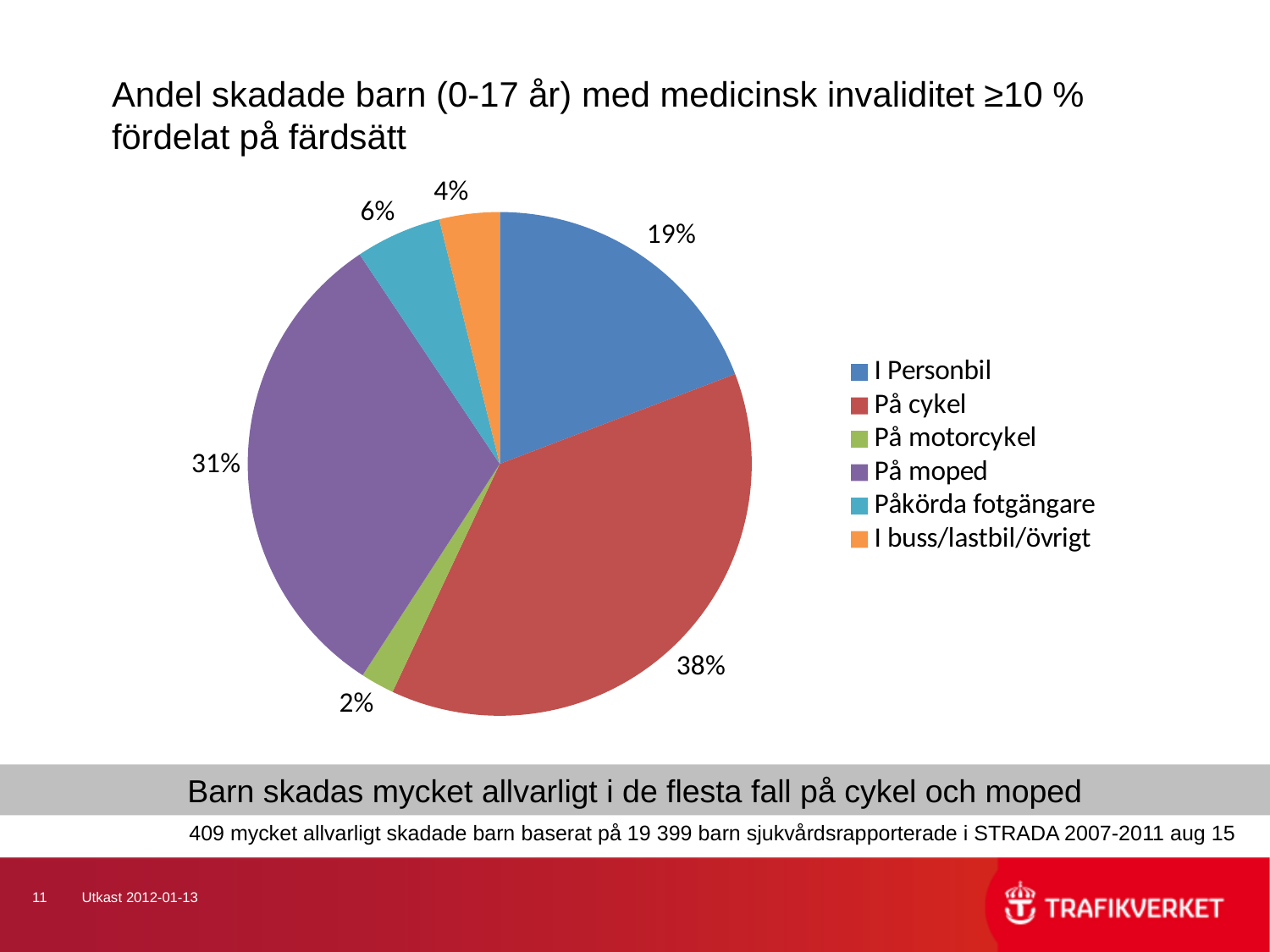
Which is larger, the slice for "I Personbil" or the slice for "Påkörda fotgängare"? I Personbil What is the value shown for "På motorcykel"? 2% What share of the pie does "På moped" have? 31% What is the difference in percentage points between "På cykel" and "På moped"? 7 What kind of chart is shown on the slide? pie chart What is the value shown for "I buss/lastbil/övrigt"? 4% What is the value shown for "I Personbil"? 19% What share of the pie does "På cykel" have? 38% Which category has the smallest slice of the pie? På motorcykel What is the value shown for "Påkörda fotgängare"? 6% Which category has the largest slice of the pie? På cykel How many categories does the legend list? 6